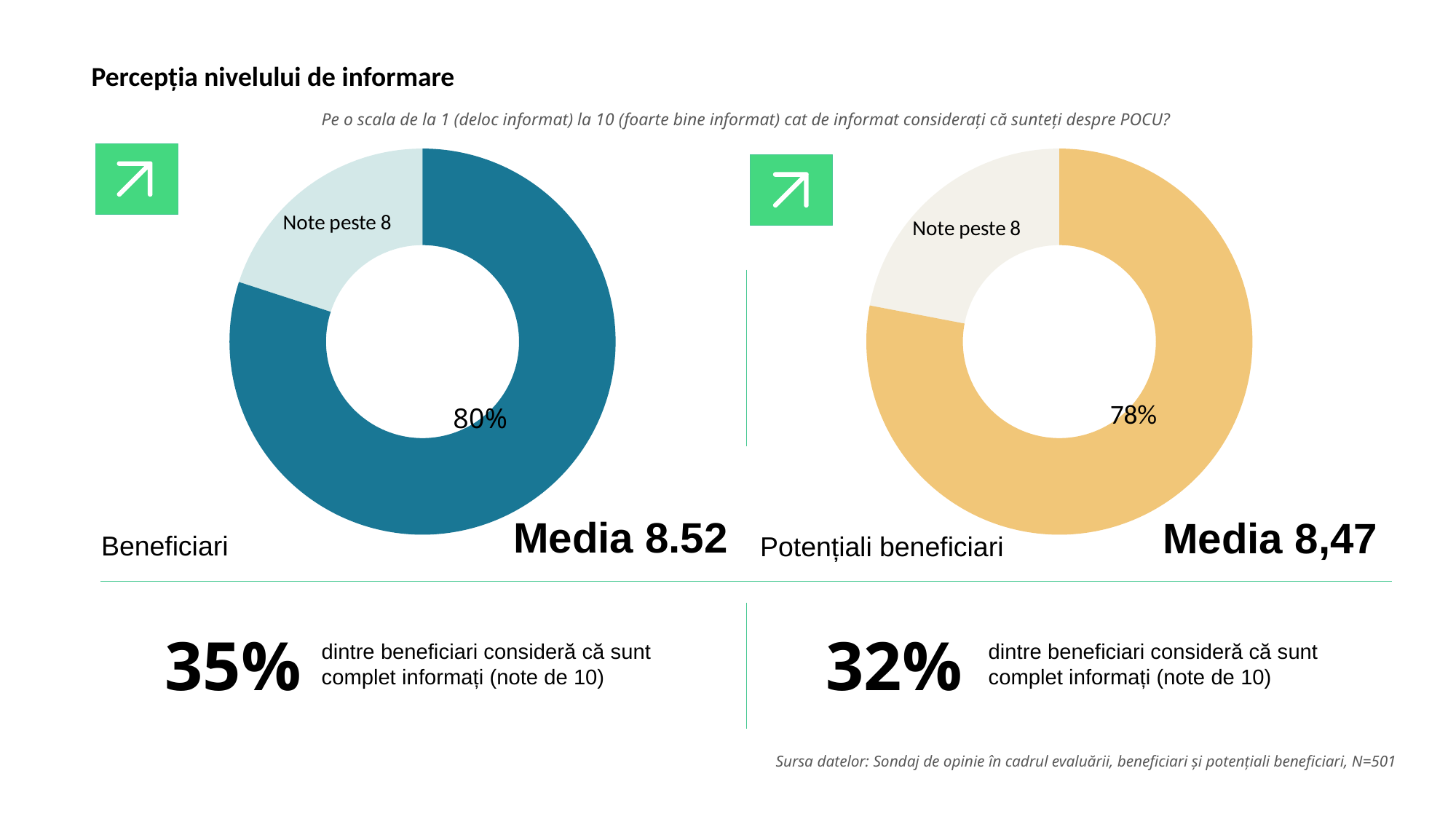
What is the text label shown on the smaller slice of each doughnut chart? Note peste 8 On the left chart (Beneficiari), what share of the doughnut does the unlabeled smaller slice represent? 20% What is the 'Media' (average) value shown for Beneficiari? 8.52 On the right chart (Potențiali beneficiari), what share of the doughnut does the unlabeled smaller slice represent? 22% What is the difference between the printed percentage on the Beneficiari chart and the one on the Potențiali beneficiari chart? 2 percentage points What kind of chart is used on this slide for Beneficiari and Potențiali beneficiari? doughnut chart What colour is the large slice of the right chart (Potențiali beneficiari)? yellow/orange On the right chart (Potențiali beneficiari), what percentage is printed on the large slice? 78% What is the 'Media' (average) value shown for Potențiali beneficiari? 8,47 Which chart shows the larger printed percentage, Beneficiari or Potențiali beneficiari? Beneficiari How many slices does the left chart (Beneficiari) have? 2 On the left chart (Beneficiari), what percentage is printed on the large slice? 80%